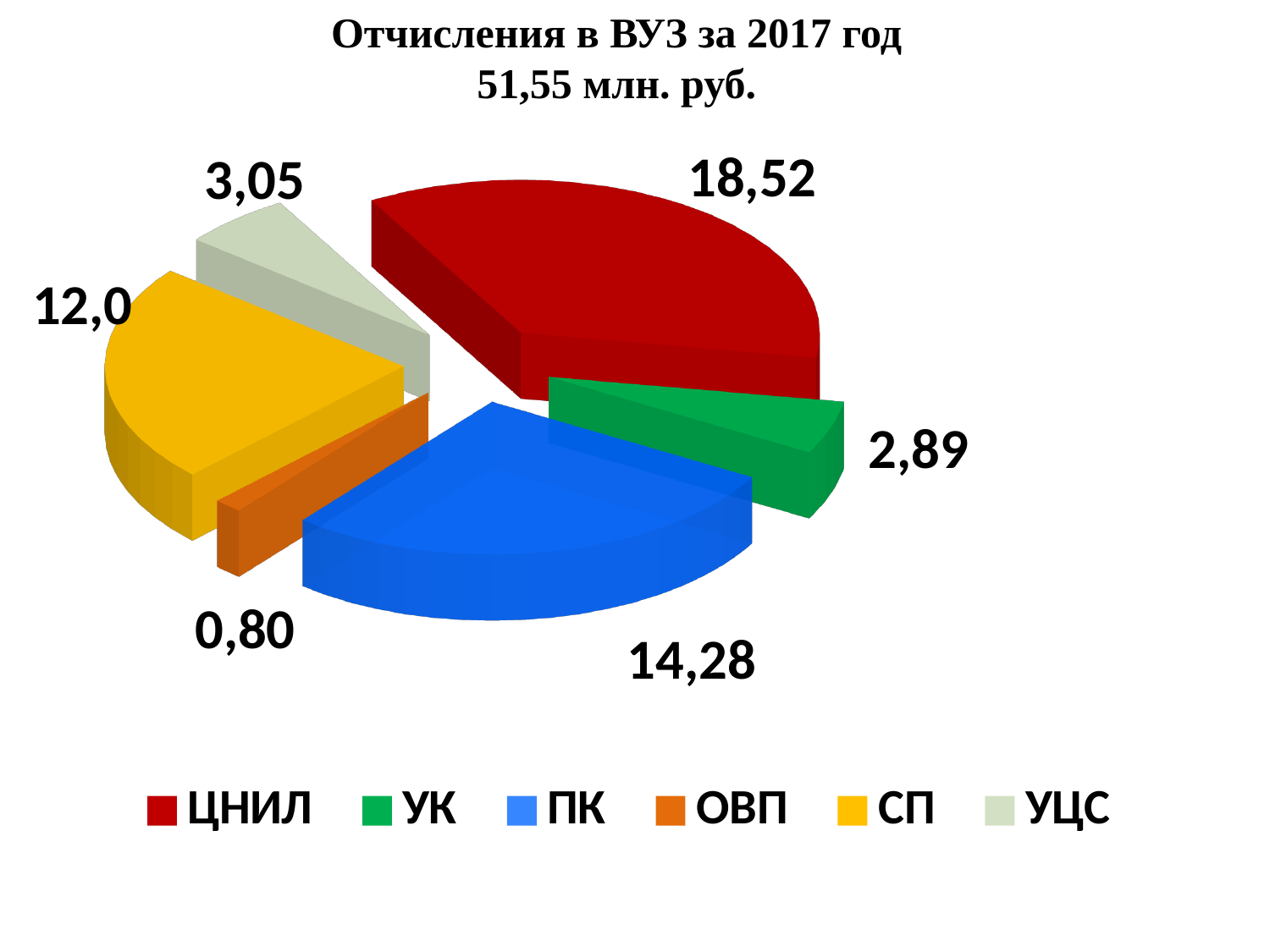
What is the value for ОВП? 0,80 How many categories does the legend list? 6 What is the difference between the values for ЦНИЛ and ПК? 4,24 What is the value for УЦС? 3,05 What total amount is stated in the chart title? 51,55 млн. руб. Which is larger, the value for УК or the value for УЦС? УЦС What is the value for ЦНИЛ? 18,52 What is the value for ПК? 14,28 What kind of chart is shown on the slide? pie chart Which category has the largest slice? ЦНИЛ What is the difference between the values for СП and УЦС? 8,95 Which category has the smallest slice? ОВП